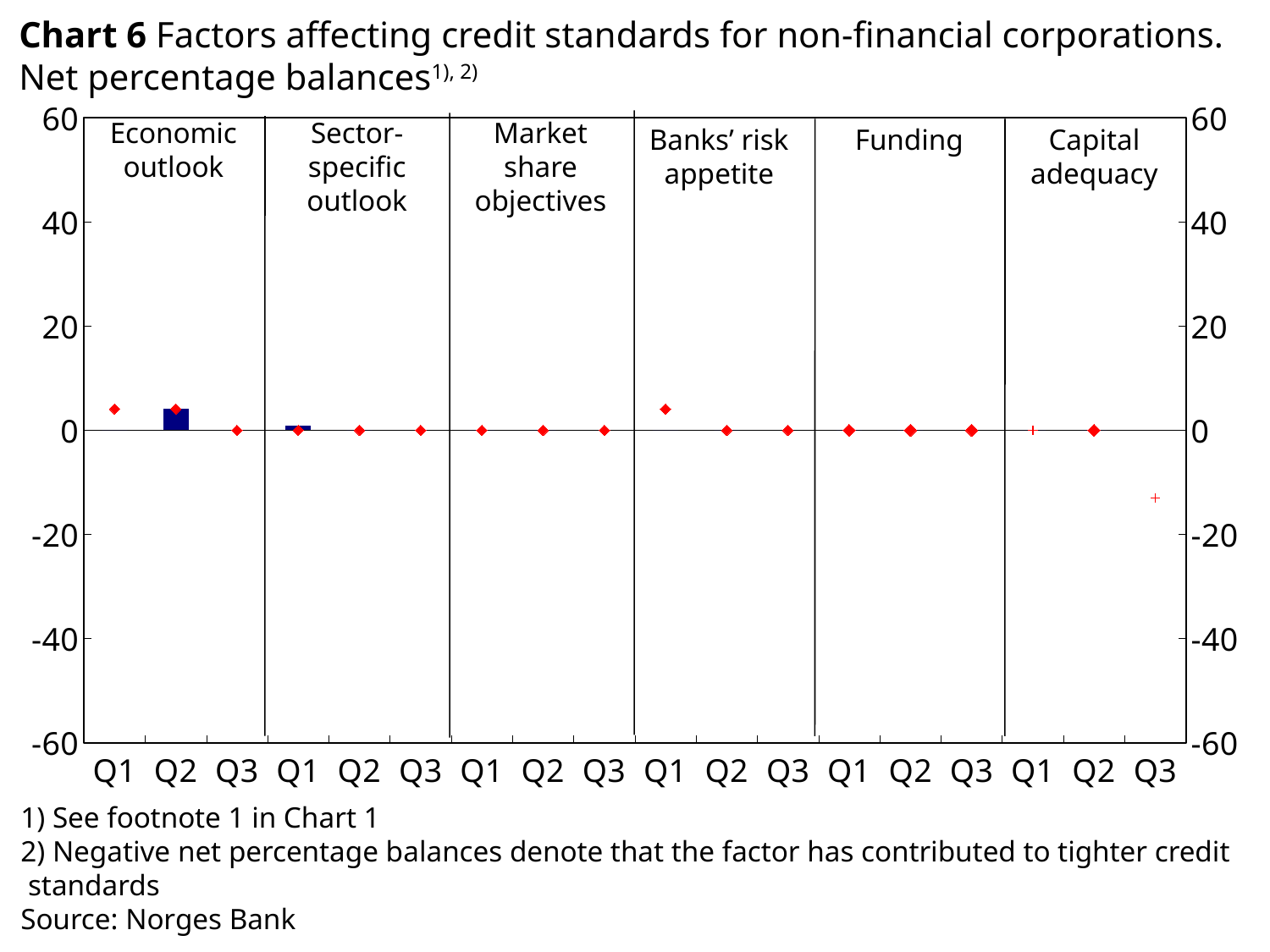
How many factor panels are shown in the chart? 6 Which factor and quarter has the lowest value in the chart? Capital adequacy, Q3 Is the value for Capital adequacy in Q3 greater or less than 0? less Is the value for Economic outlook in Q2 greater or less than 0? greater What is the highest value shown on the vertical axis? 60 Is the value for Economic outlook in Q2 greater or less than 20? less How many quarters are shown within each factor panel? 3 What is the source given for the chart? Norges Bank Which is larger: the value for Economic outlook in Q2 or the value for Capital adequacy in Q3? Economic outlook in Q2 What kind of chart is shown on the slide? Combination bar and line (marker) chart